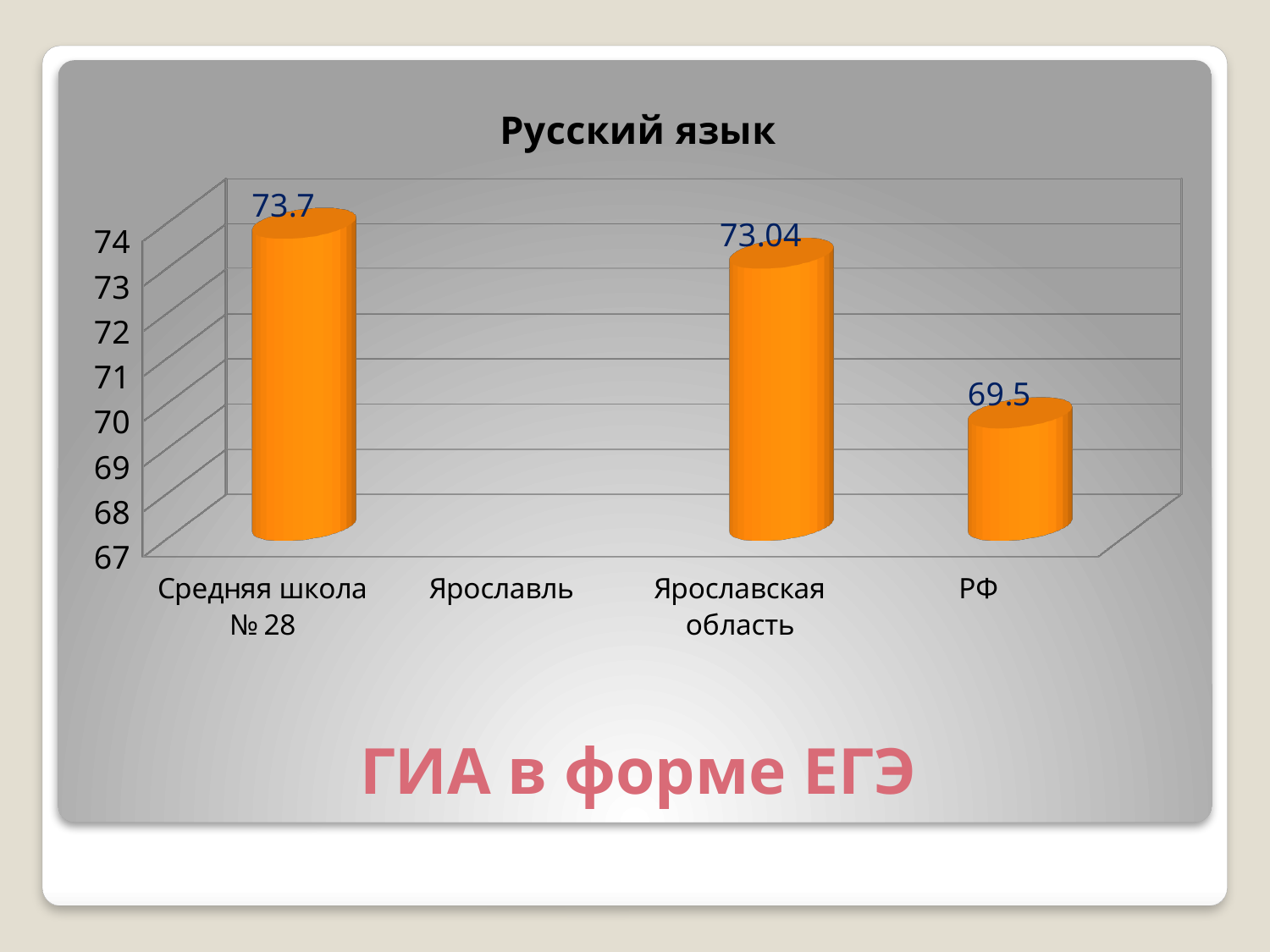
Which is larger, the value for Ярославская область or the value for РФ? Ярославская область What kind of chart is shown? bar chart What is the value for РФ? 69.5 What is the difference between the values for Средняя школа № 28 and РФ? 4.2 Which category has the highest value? Средняя школа № 28 What is the difference between the values for Ярославская область and РФ? 3.54 What is the value for Ярославская область? 73.04 How many categories are labelled on the x axis? 4 Is the value for РФ greater or less than 70? less Which category with a plotted bar has the lowest value? РФ What is the value for Средняя школа № 28? 73.7 What is the title of the chart? Русский язык